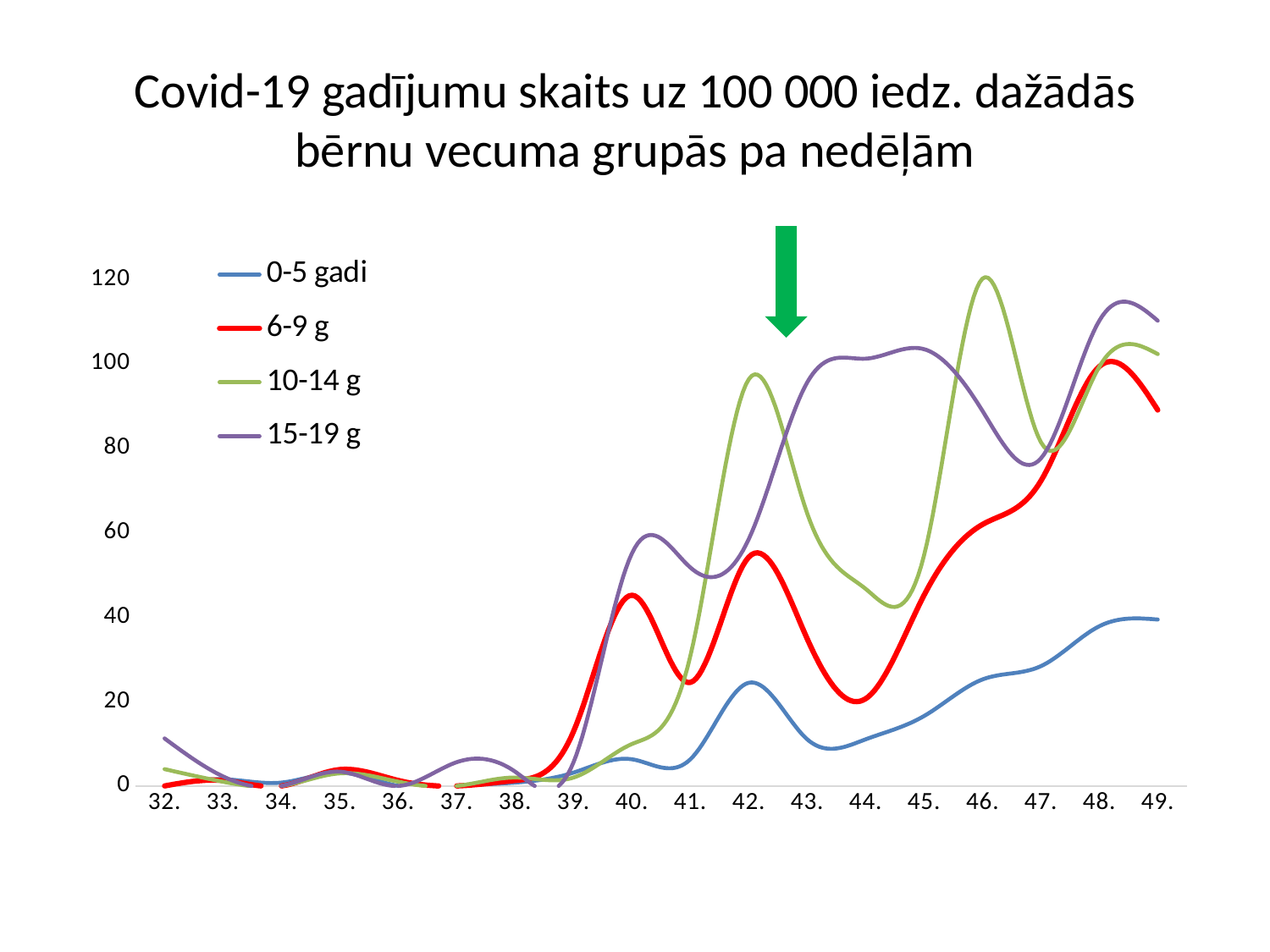
Is the value for 6-9 g at week 42 greater or less than 40? greater Does the value for 0-5 gadi rise or fall from week 44 to week 49? rise Is the value for 10-14 g at week 46 greater or less than 100? greater Is the value for 0-5 gadi at week 44 greater or less than 20? less At week 42, which is larger: the value for 10-14 g or the value for 6-9 g? 10-14 g What kind of chart is shown on the slide? line chart What colour is the line for the 6-9 g series? red Which age group has the lowest value at week 49? 0-5 gadi How many weeks are shown along the x axis? 18 How many series does the legend list? 4 Which age group has the highest value at week 46? 10-14 g